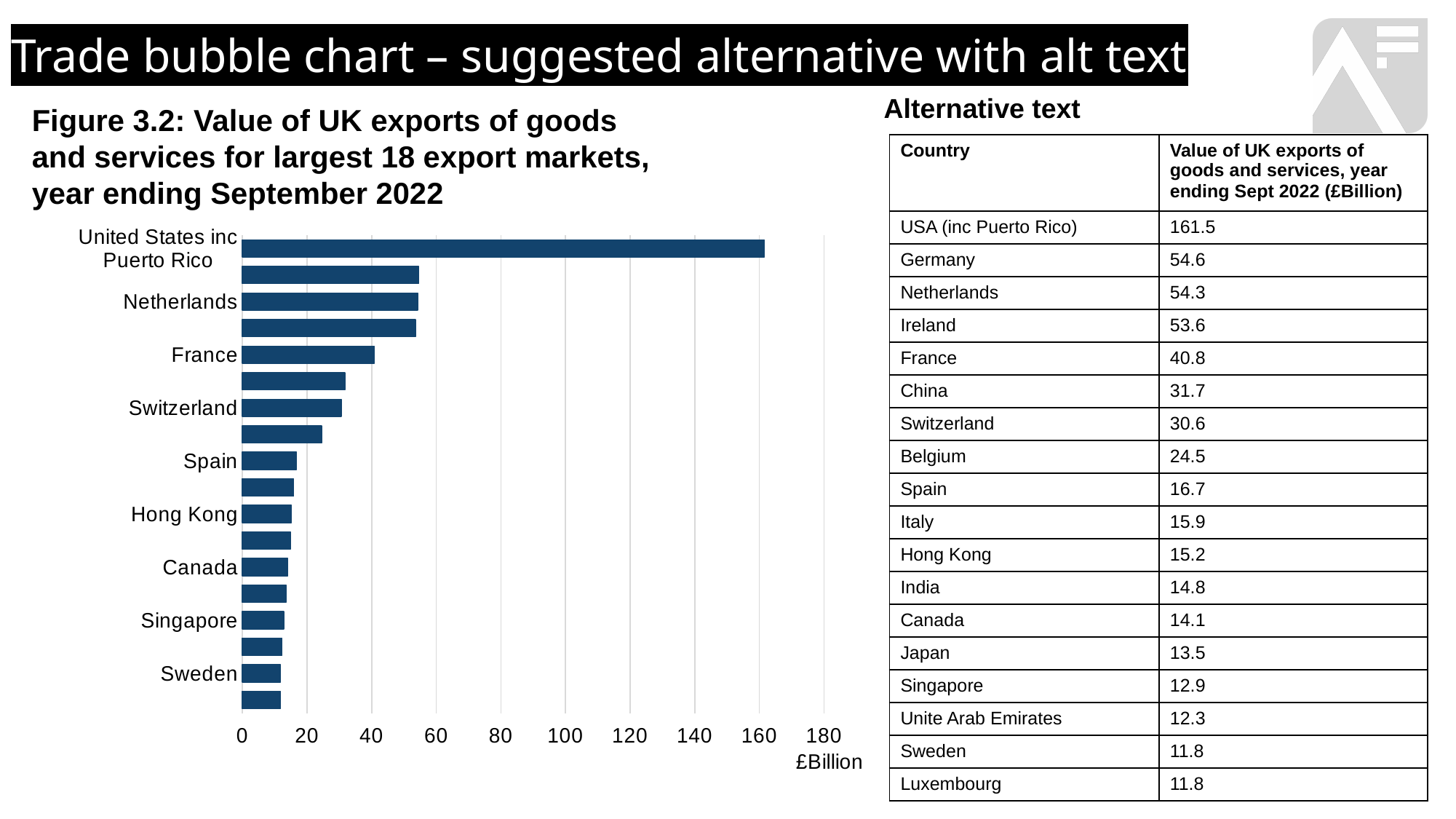
What kind of chart is shown on the slide? bar chart Which is larger, the value for Netherlands or the value for France? Netherlands Is the value for France greater or less than 60? less What unit is shown on the x axis of the bar chart? £Billion Do the bar values rise or fall going from the top of the chart to the bottom? fall Is the value for Netherlands greater or less than 40? greater Is the value for Switzerland greater or less than 40? less Which country has the highest value of UK exports in the bar chart? United States inc Puerto Rico How many bars are plotted in the bar chart? 18 Which is larger, the value for Switzerland or the value for Spain? Switzerland According to the alternative text table, what is the value of UK exports to France in £Billion? 40.8